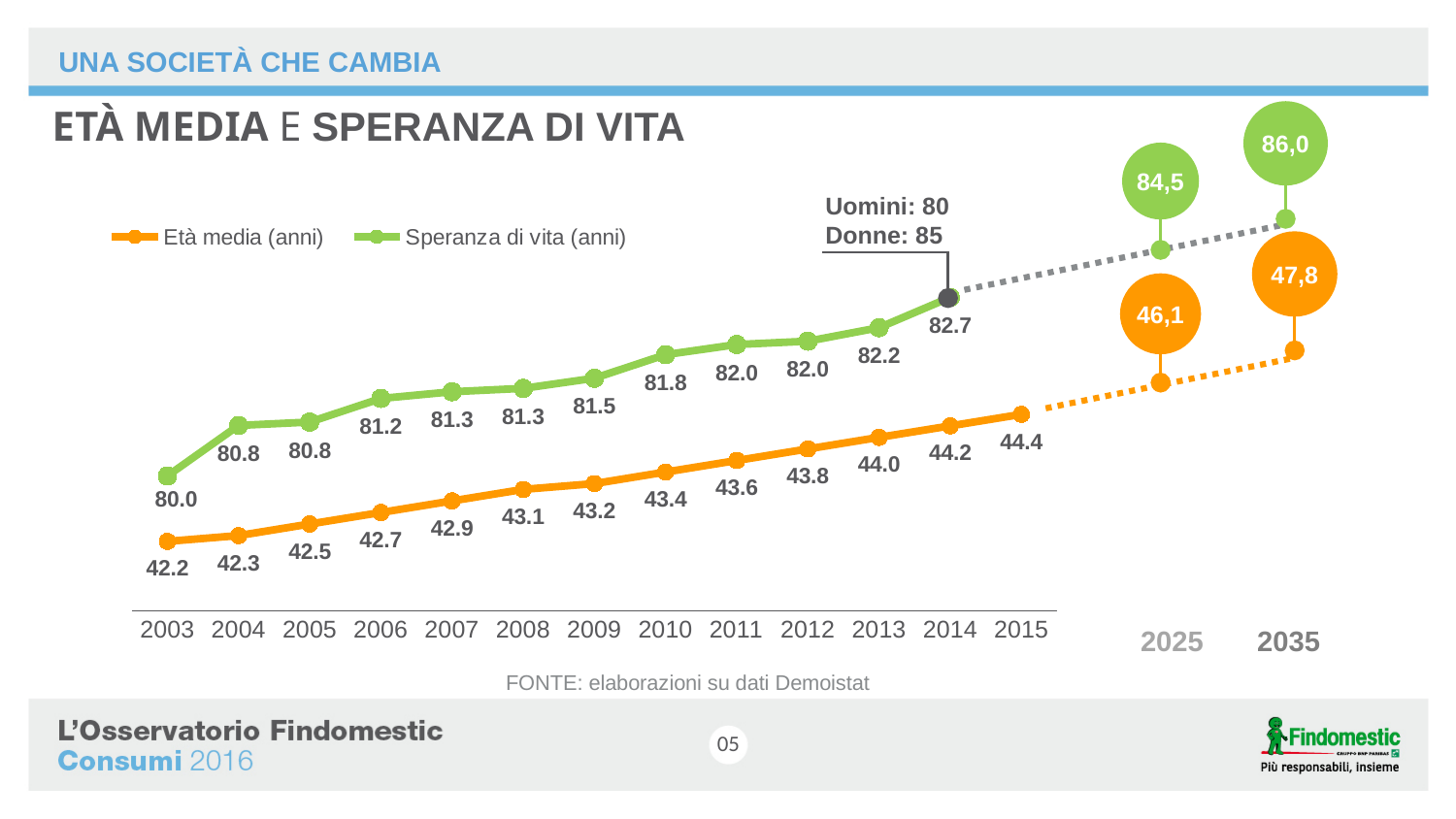
What type of chart is shown on the slide? line chart How many series does the legend list? 2 What is the value of Speranza di vita (anni) in 2010? 81.8 What is the value of Età media (anni) in 2003? 42.2 What is the value of Età media (anni) in 2015? 44.4 What is the difference between Speranza di vita (anni) in 2014 and in 2013? 0.5 By how much did Età media (anni) increase from 2003 to 2015? 2.2 Does Età media (anni) rise or fall from 2003 to 2015? rise What is the projected value of Età media (anni) for 2025? 46,1 According to the annotation on the chart, what is the life expectancy value given for Donne? 85 What is the projected value of Speranza di vita (anni) for 2035? 86,0 Which year has the higher Speranza di vita (anni), 2003 or 2004? 2004